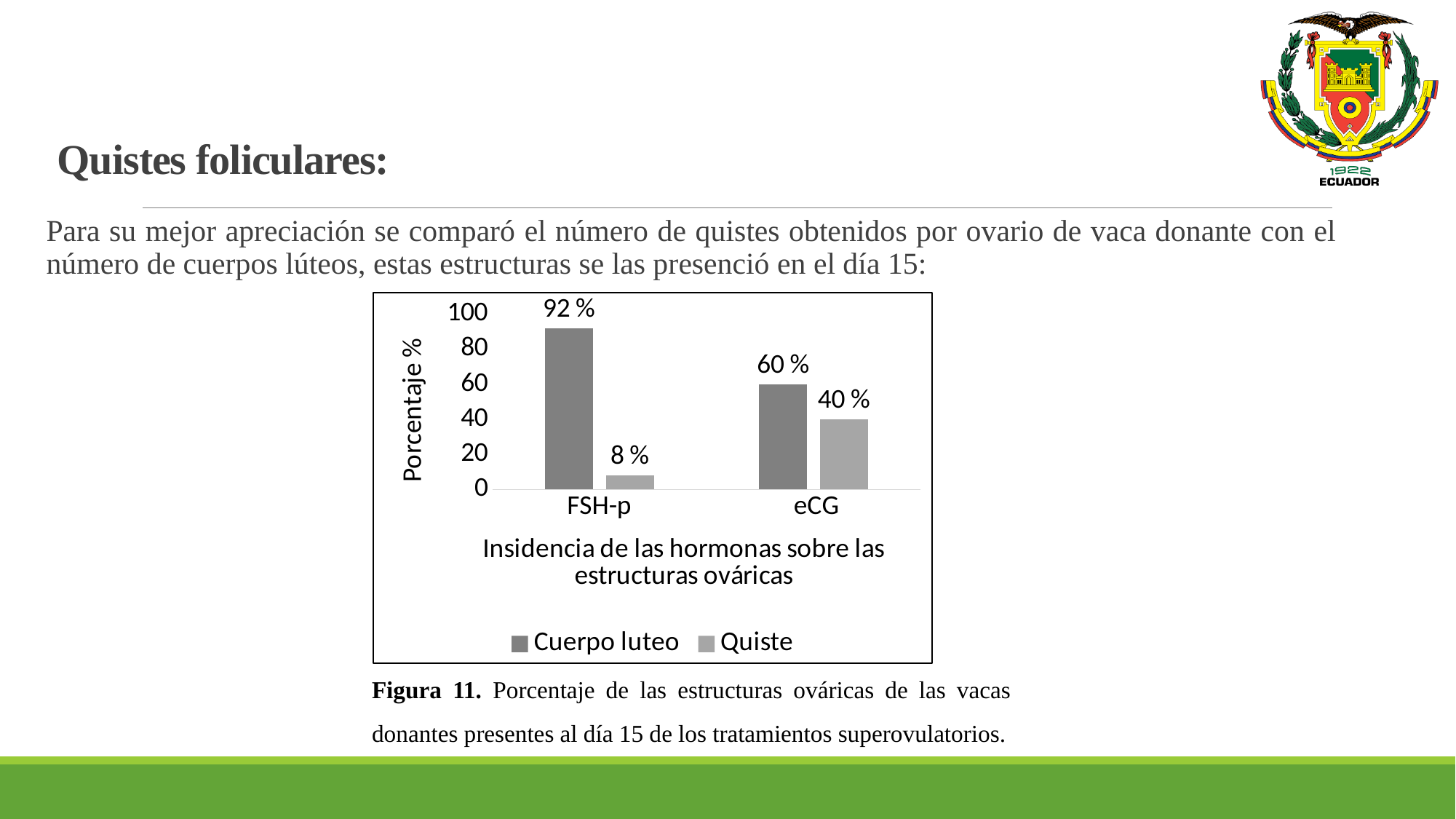
What is the value for Quiste in the FSH-p category? 8 % What is the value for Cuerpo luteo in the FSH-p category? 92 % What is the value for Cuerpo luteo in the eCG category? 60 % What is the value for Quiste in the eCG category? 40 % What is the difference between the Quiste values for eCG and FSH-p? 32 % How many categories are shown on the x axis? 2 What kind of chart is shown on the slide? Bar chart What is the difference between the Cuerpo luteo and Quiste values for FSH-p? 84 % Which category has the highest Cuerpo luteo value? FSH-p Which category has the lowest Quiste value? FSH-p How many series does the legend list? 2 Which is larger: the Cuerpo luteo value for eCG or the Quiste value for eCG? Cuerpo luteo